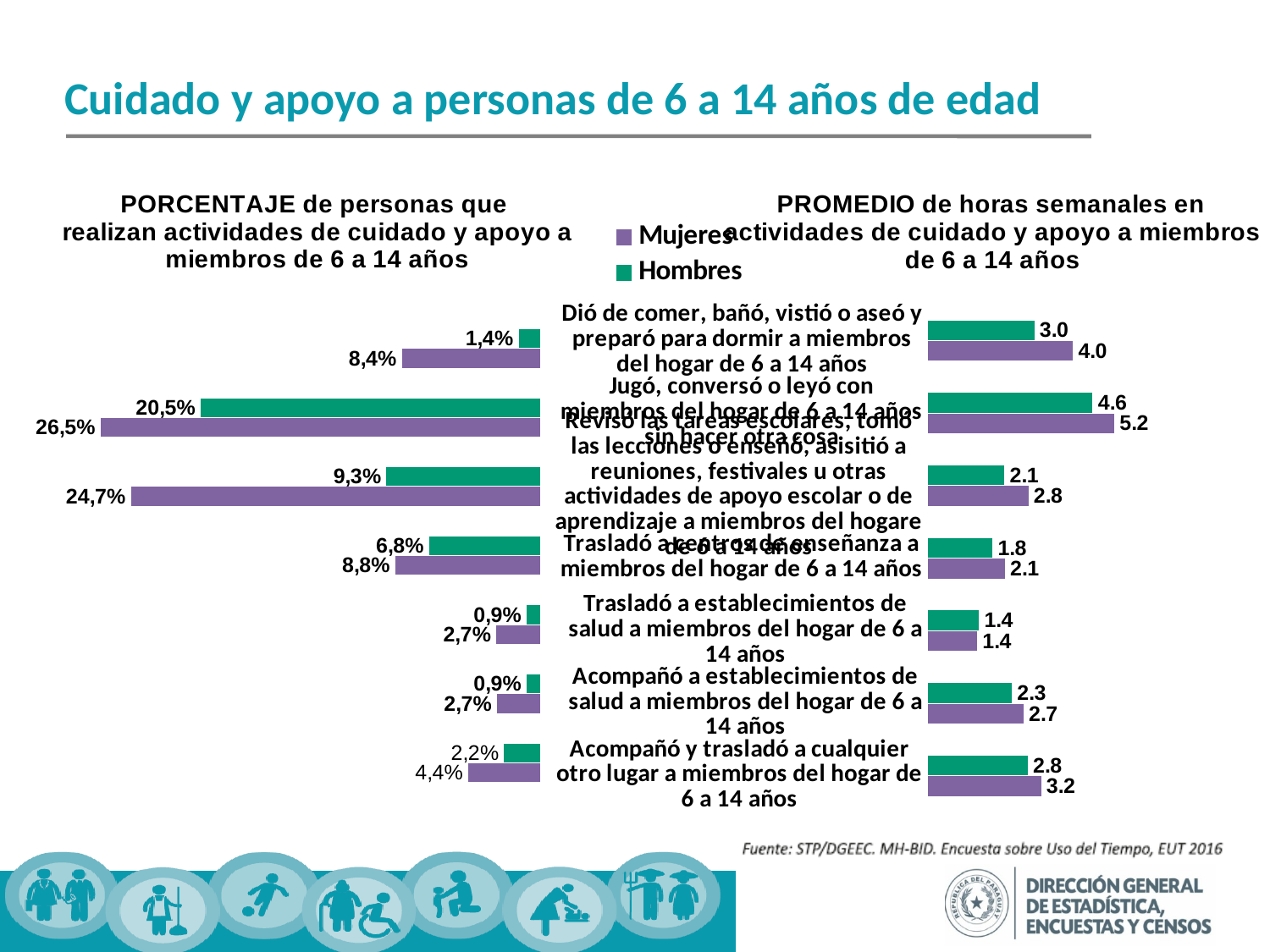
In the right chart (PROMEDIO de horas semanales), which is larger for 'Acompañó a establecimientos de salud a miembros del hogar de 6 a 14 años', Mujeres or Hombres? Mujeres In the right chart (PROMEDIO de horas semanales), what is the highest value shown for Hombres? 4.6 How many categories are shown in the left chart (PORCENTAJE)? 7 How many series does the legend list? 2 In the left chart (PORCENTAJE), which category has the highest value for Mujeres? Jugó, conversó o leyó con miembros del hogar de 6 a 14 años sin hacer otra cosa (26,5%) What type of chart is the right chart (PROMEDIO de horas semanales)? Bar chart In the left chart (PORCENTAJE de personas que realizan actividades de cuidado y apoyo a miembros de 6 a 14 años), what is the value for Mujeres for 'Dió de comer, bañó, vistió o aseó y preparó para dormir a miembros del hogar de 6 a 14 años'? 8,4% In the right chart (PROMEDIO de horas semanales), what is the value for Hombres for 'Trasladó a establecimientos de salud a miembros del hogar de 6 a 14 años'? 1.4 In the right chart (PROMEDIO de horas semanales), what is the difference between Mujeres and Hombres for 'Dió de comer, bañó, vistió o aseó y preparó para dormir a miembros del hogar de 6 a 14 años'? 1.0 In the left chart (PORCENTAJE), what is the difference between Mujeres and Hombres for 'Acompañó y trasladó a cualquier otro lugar a miembros del hogar de 6 a 14 años'? 2,2% In the left chart (PORCENTAJE), what is the value for Hombres for 'Dió de comer, bañó, vistió o aseó y preparó para dormir a miembros del hogar de 6 a 14 años'? 1,4% In the right chart (PROMEDIO de horas semanales), what is the value for Mujeres for 'Acompañó y trasladó a cualquier otro lugar a miembros del hogar de 6 a 14 años'? 3.2